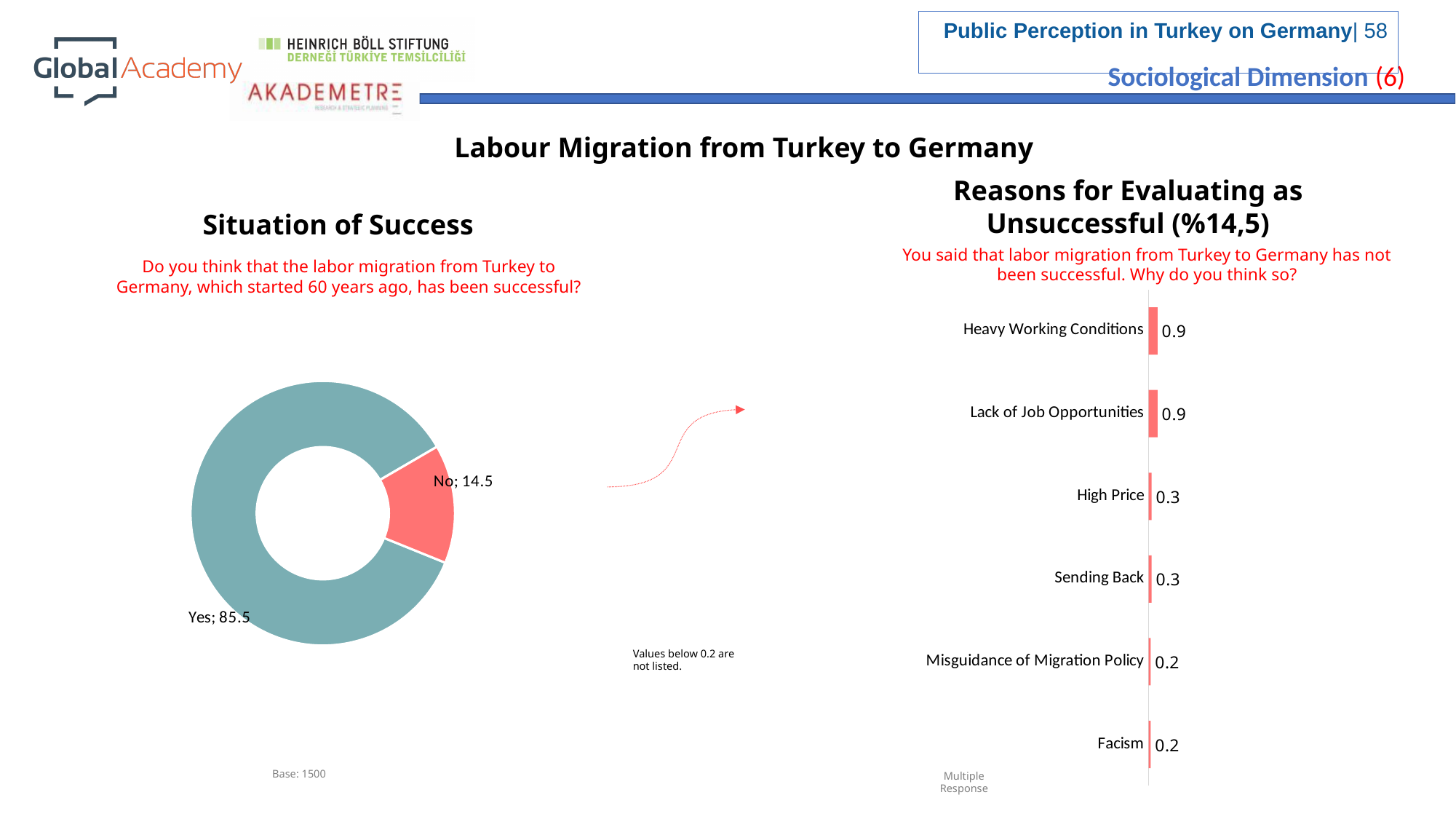
In the 'Reasons for Evaluating as Unsuccessful' chart, what is the value for Facism? 0.2 In the 'Reasons for Evaluating as Unsuccessful' chart, which is larger, Heavy Working Conditions or Misguidance of Migration Policy? Heavy Working Conditions In the 'Situation of Success' chart, which slice is larger, Yes or No? Yes In the 'Reasons for Evaluating as Unsuccessful' chart, what is the value for Heavy Working Conditions? 0.9 How many categories are shown in the 'Reasons for Evaluating as Unsuccessful' chart? 6 What kind of chart is the 'Situation of Success' chart? Doughnut chart What kind of chart is the 'Reasons for Evaluating as Unsuccessful' chart? Bar chart In the 'Situation of Success' chart, what is the difference between the Yes and No values? 71 In the 'Reasons for Evaluating as Unsuccessful' chart, what is the difference between Lack of Job Opportunities and Sending Back? 0.6 In the 'Situation of Success' chart, what is the value for Yes? 85.5 In the 'Reasons for Evaluating as Unsuccessful' chart, what is the value for High Price? 0.3 In the 'Situation of Success' chart, what is the value for No? 14.5